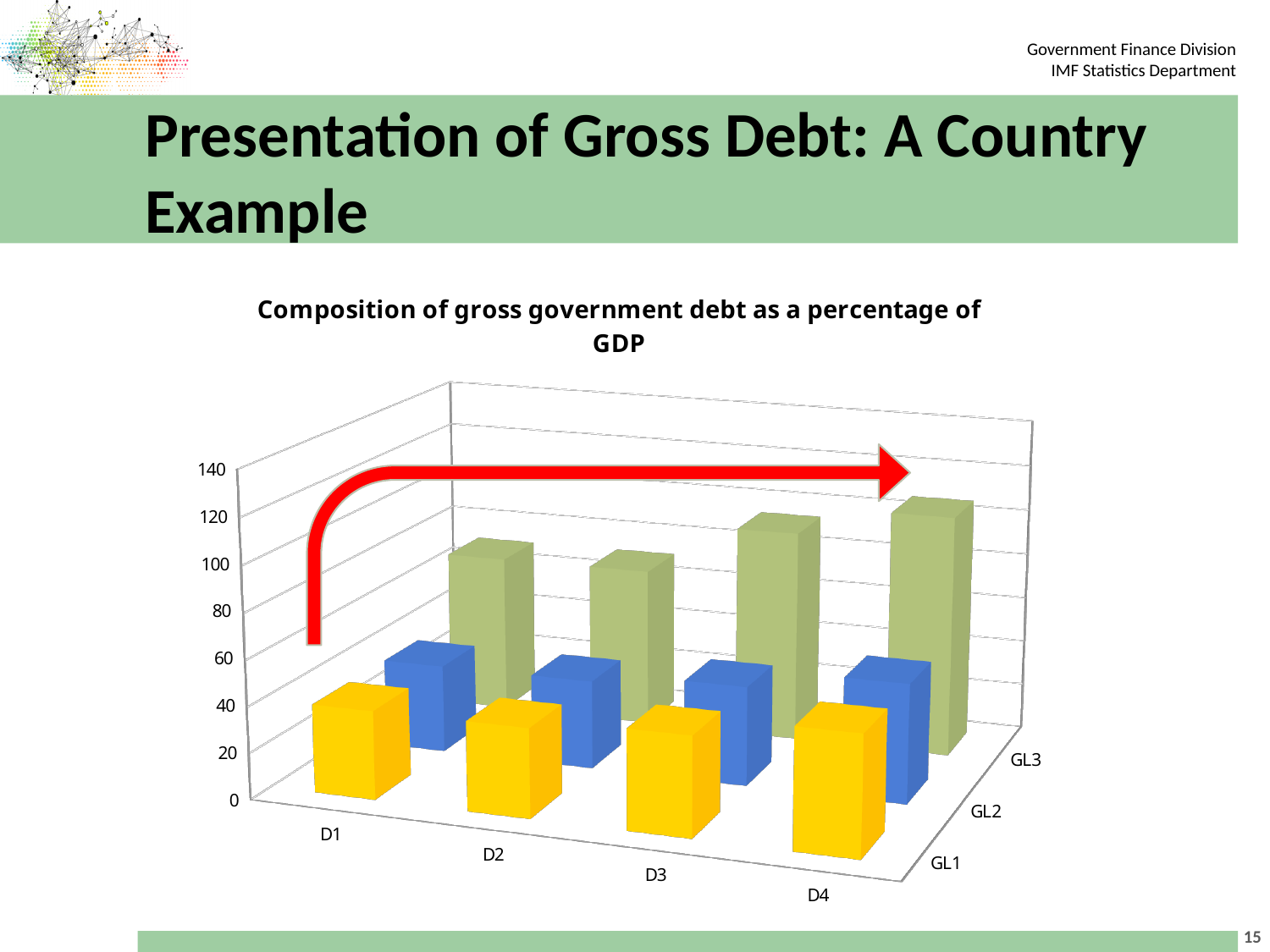
What kind of chart is shown on the slide? bar chart What colour are the GL3 bars in the chart? green What is the title of the chart? Composition of gross government debt as a percentage of GDP Is the GL2 value for D1 greater or less than 80? less How many series (GL1, GL2, GL3) are plotted in the chart? 3 Is the GL3 value for D4 greater or less than 80? greater For D4, which is larger: the GL3 value or the GL1 value? GL3 Is the GL1 value for D1 greater or less than 80? less For D3, which is larger: the GL3 value or the GL2 value? GL3 Which category has the highest GL3 value? D4 How many categories (D1 to D4) are shown along the front axis of the chart? 4